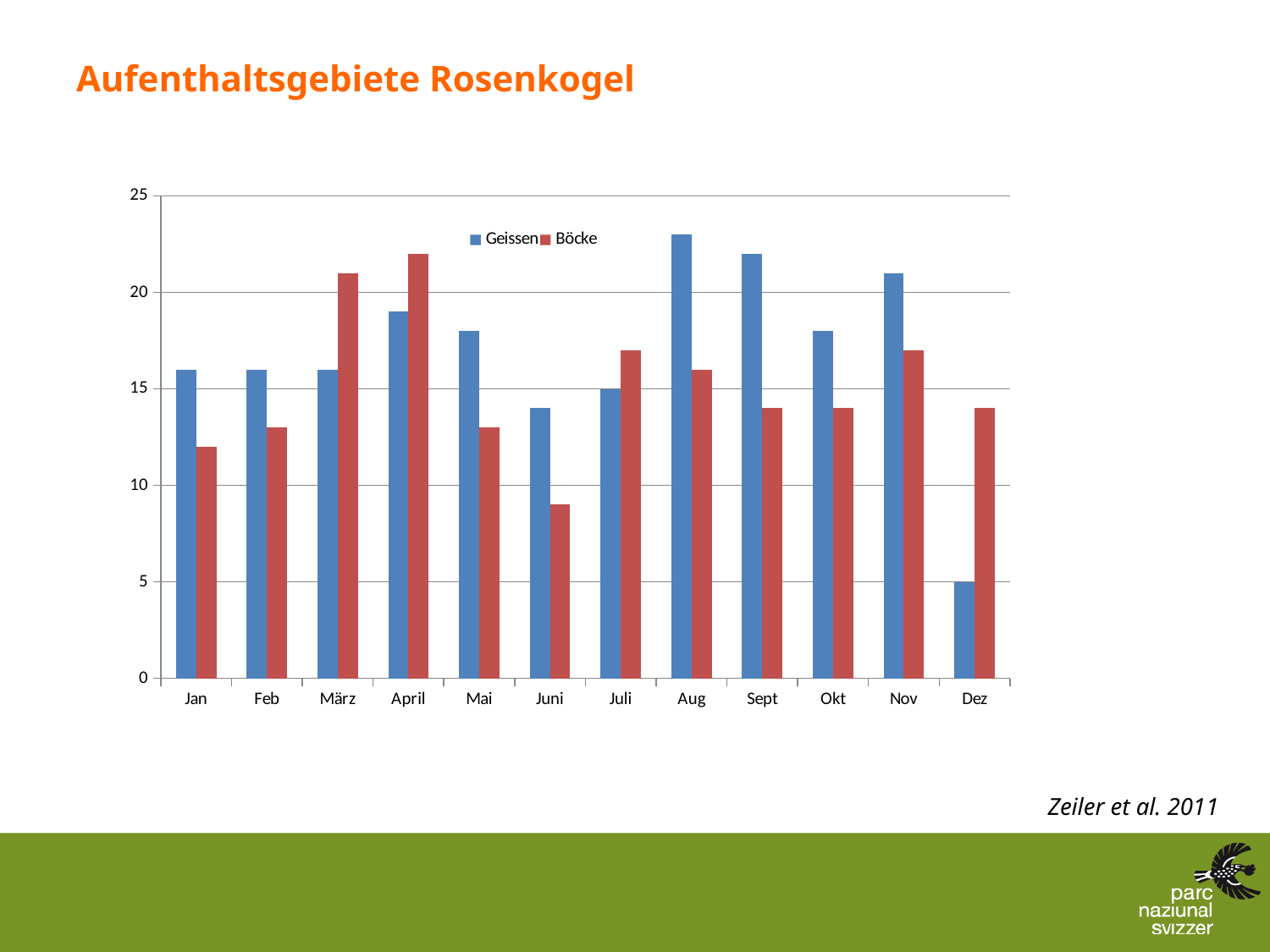
Is the value for Böcke in März greater or less than 20? greater In which month is the value for Geissen lowest? Dez In Dez, which is larger: Geissen or Böcke? Böcke In Jan, which is larger: Geissen or Böcke? Geissen How many months are shown on the x axis? 12 In which month is the value for Böcke lowest? Juni Is the value for Geissen in Aug greater or less than 20? greater What kind of chart is shown on the slide? bar chart How many series does the legend list? 2 What is the value for Geissen in Dez? 5 Is the value for Böcke in Juni greater or less than 10? less What is the value for Geissen in Juli? 15